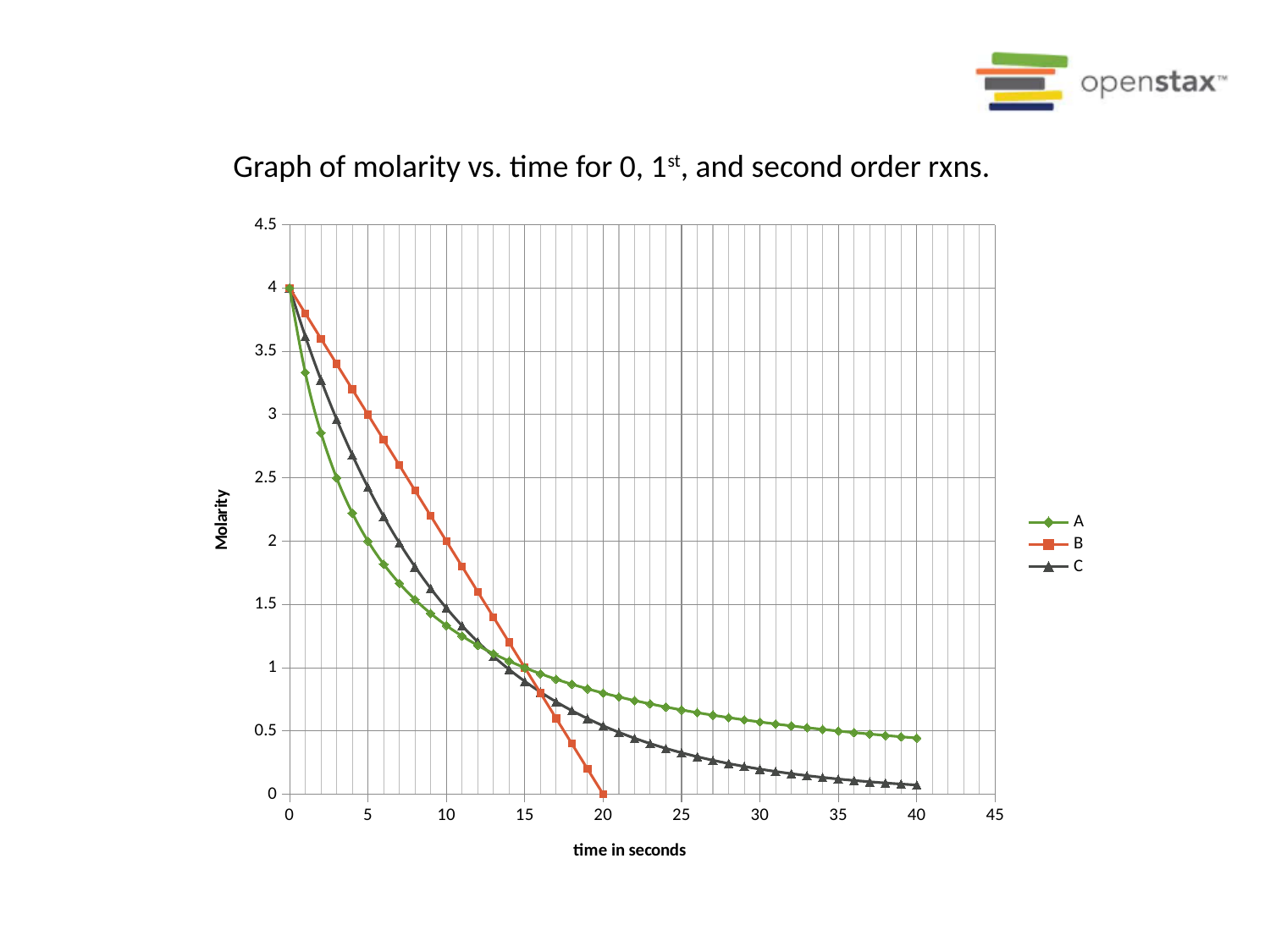
Which series has the highest molarity at 10 seconds? B What kind of chart is shown on the slide? line chart Is the molarity of series B at 2 seconds greater or less than 3.5? greater At 30 seconds, which series has the higher molarity, A or C? A What is the molarity of series B at 10 seconds? 2 What is the molarity of series B at 20 seconds? 0 What is the molarity of series A at 0 seconds? 4 At 5 seconds, which series has the higher molarity, A or B? B Do the molarity values rise or fall as time increases? fall What is the title of the x axis? time in seconds How many series does the legend list? 3 Is the molarity of series C at 30 seconds greater or less than 0.5? less